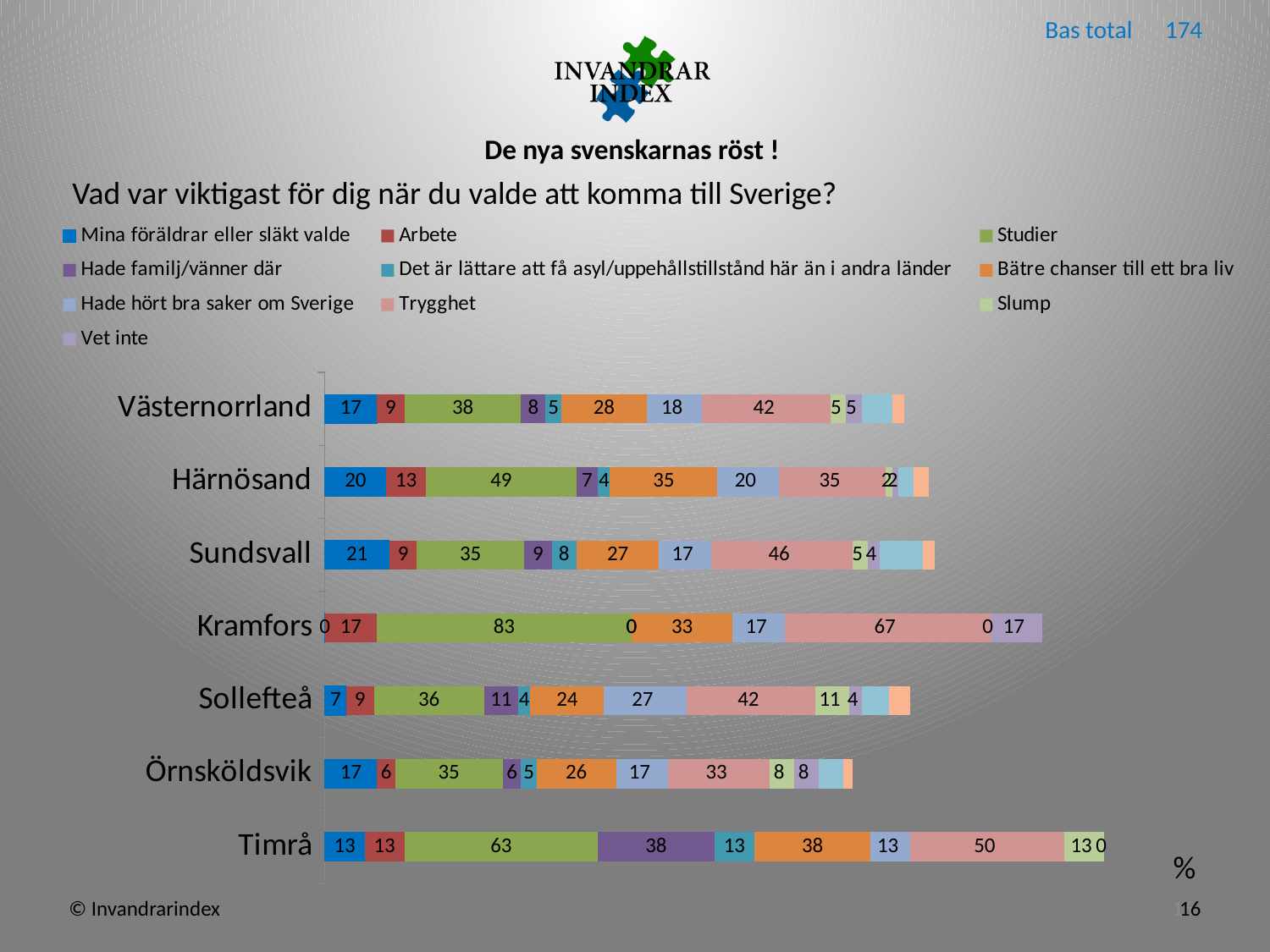
What is the value for Arbete for Härnösand? 13 What is the value for Trygghet for Sundsvall? 46 Which region has the lowest value for Mina föräldrar eller släkt valde? Kramfors What is the value for Hade hört bra saker om Sverige for Sollefteå? 27 Which region has the highest value for Studier? Kramfors Which has the larger Trygghet value, Västernorrland or Örnsköldsvik? Västernorrland What is the value for Studier for Härnösand? 49 What kind of chart is shown on the slide? Stacked bar chart How many regions (categories) are plotted on the chart? 7 What is the value for Bätre chanser till ett bra liv for Timrå? 38 What is the Bas total shown on the slide? 174 What is the difference between the Mina föräldrar eller släkt valde values for Sundsvall and Sollefteå? 14